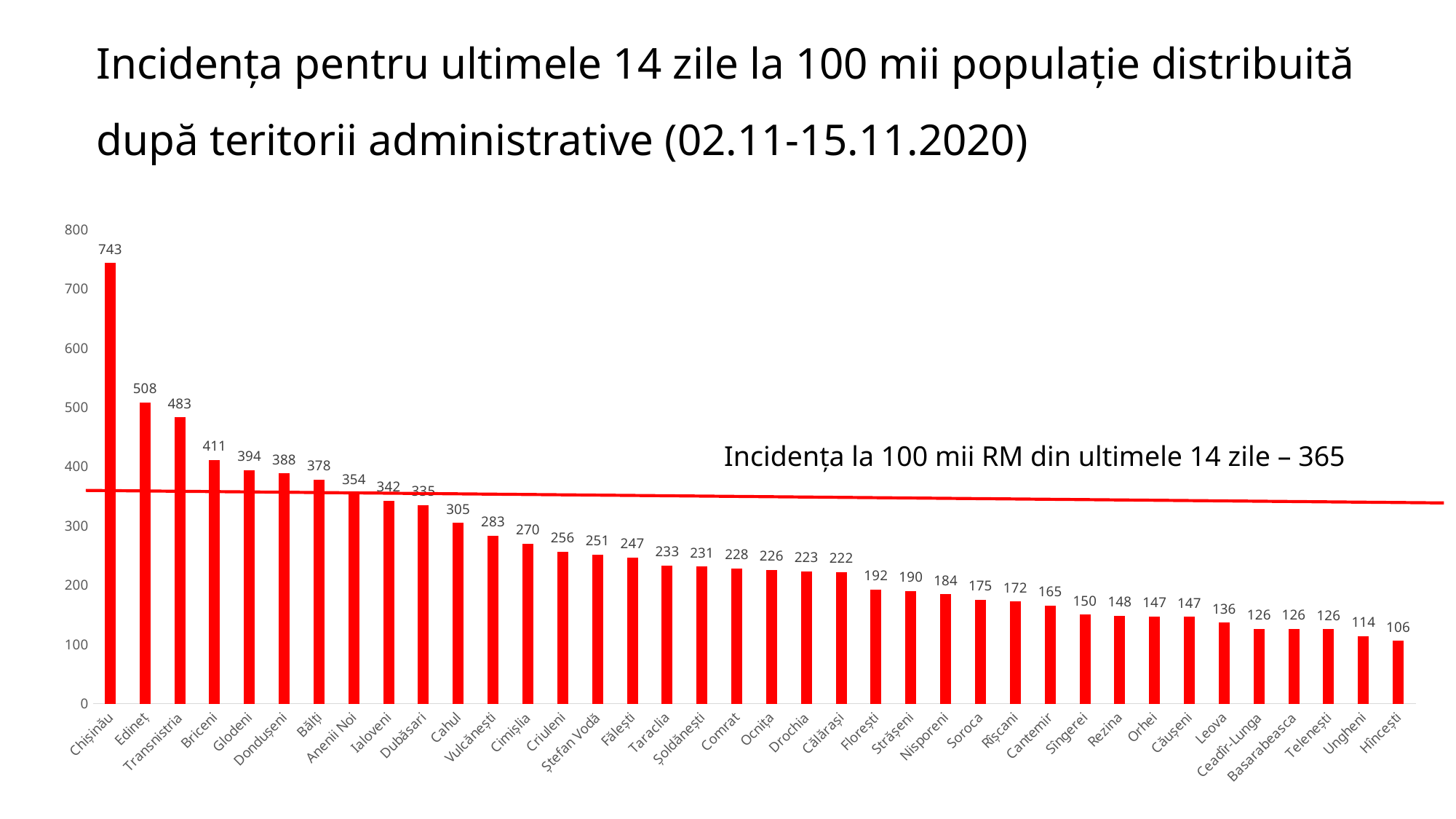
What kind of chart is this? bar chart What is the value for Chișinău? 743 Is the value for Ialoveni greater or less than 300? greater What is the value for Cahul? 305 Which territory has the lowest value? Hîncești What national incidence value is indicated by the horizontal line label? 365 Which territory has the highest value? Chișinău How many territories are shown on the chart? 38 What is the value for Soroca? 175 Which has a larger value, Briceni or Bălți? Briceni What is the difference between the values for Edineț and Transnistria? 25 Do the values rise or fall from left to right along the x axis? fall